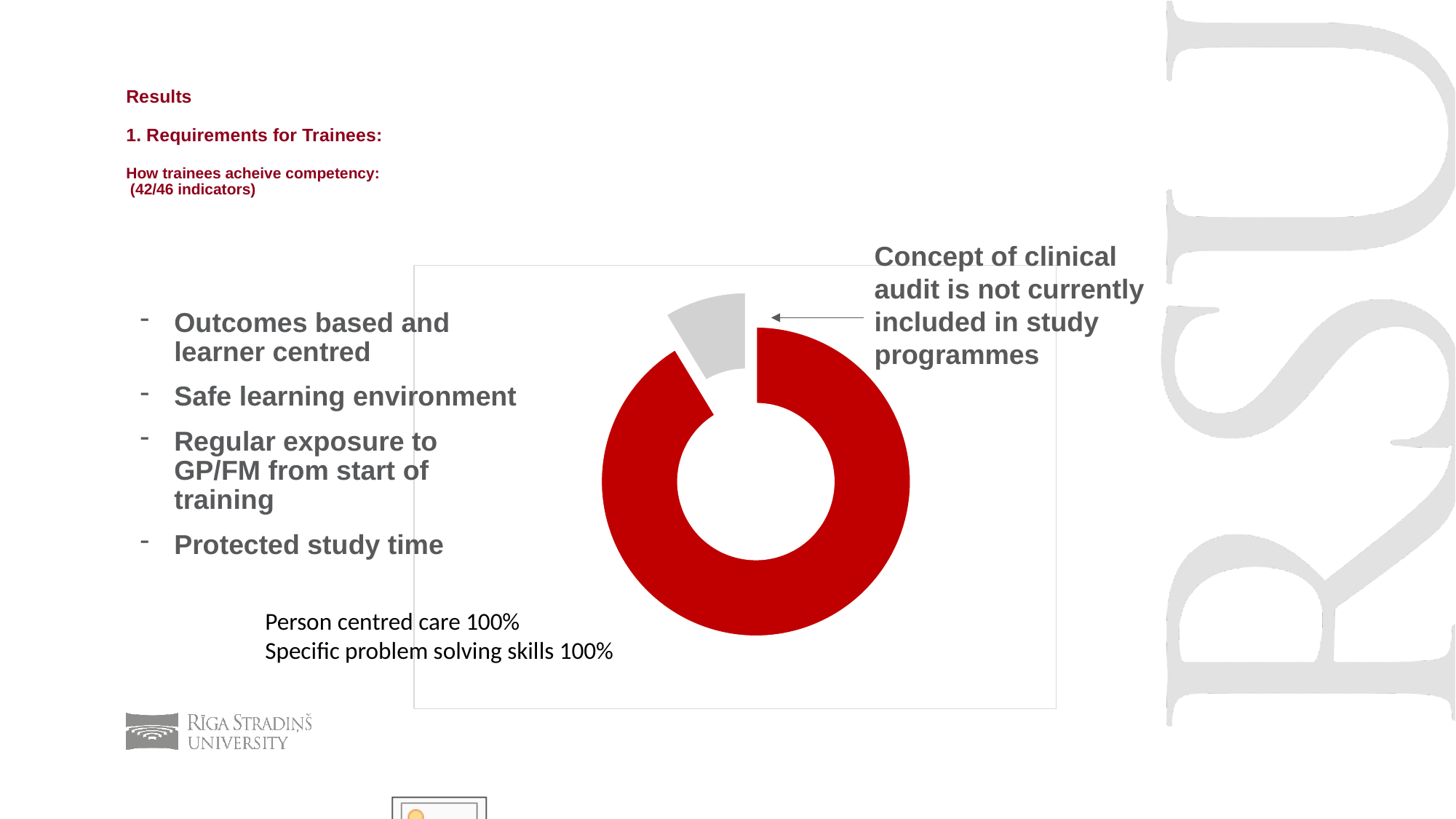
How many slices does the doughnut chart have? 2 Which slice of the doughnut chart is pulled out (exploded) from the ring? The grey slice What kind of chart is shown on the slide? Doughnut (pie) chart Which slice of the doughnut chart is larger, the red slice or the grey slice? The red slice Is the grey slice of the doughnut chart greater or less than half of the chart? less Which slice of the doughnut chart is the smallest? The grey slice What colour is the largest slice of the doughnut chart? Red Is the red slice of the doughnut chart greater or less than half of the chart? greater